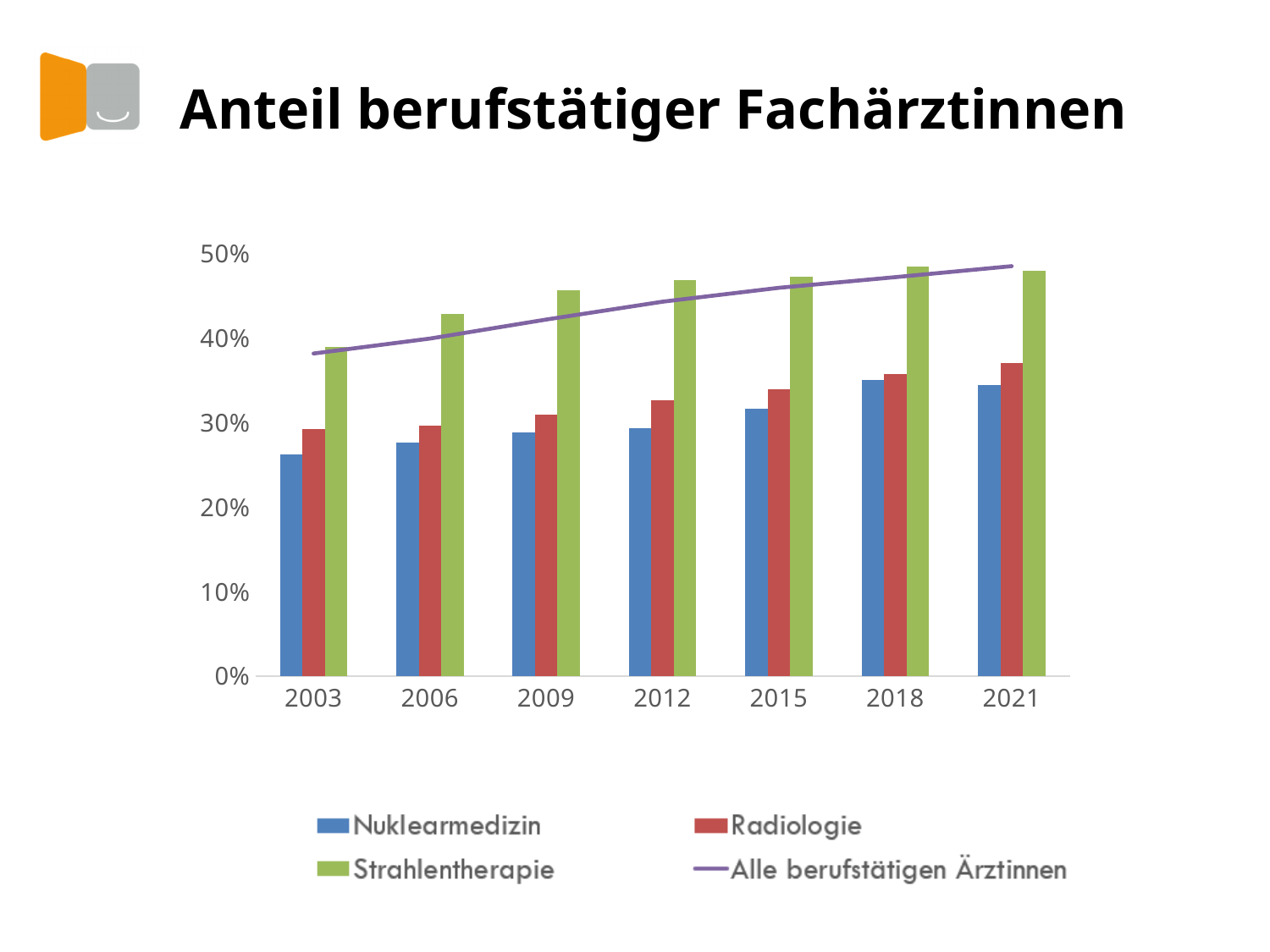
In which year is the value for Nuklearmedizin lowest? 2003 Is the value for Strahlentherapie in 2009 greater or less than 40%? greater Is the value for Nuklearmedizin in 2003 greater or less than 30%? less How many series does the legend list? 4 Is the value for Radiologie in 2021 greater or less than 40%? less In 2003, which is larger: the value for Strahlentherapie or the value for Nuklearmedizin? Strahlentherapie Which bar series has the highest value in 2012? Strahlentherapie What kind of chart is shown on the slide? combination bar and line chart Which series is drawn as a line rather than bars? Alle berufstätigen Ärztinnen Which bar series has the lowest value in 2018? Nuklearmedizin How many years are shown on the x axis? 7 Do the values for Radiologie rise or fall from 2003 to 2021? rise